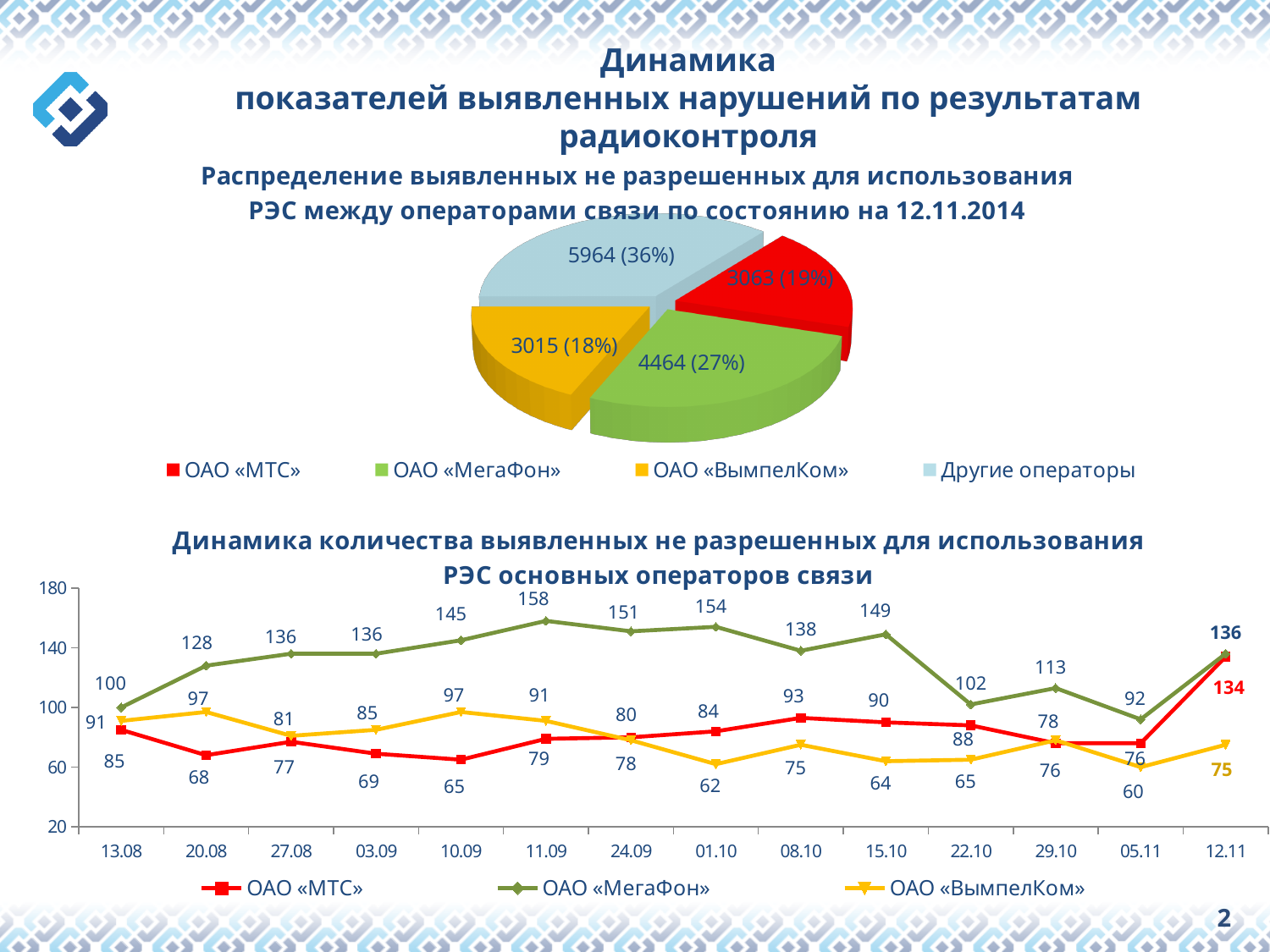
In the pie chart, what is the difference between the values for ОАО «МТС» and ОАО «ВымпелКом»? 48 In the pie chart, what value and share are shown for Другие операторы? 5964 (36%) In the line chart, what is the value for ОАО «МТС» on 12.11? 134 What type of chart is the bottom chart on the slide? Line chart How many series does the legend of the line chart list? 3 In the line chart, what is the value for ОАО «ВымпелКом» on 05.11? 60 In the pie chart, what value and share are shown for ОАО «МегаФон»? 4464 (27%) In the line chart, on which date does ОАО «МегаФон» reach its highest value? 11.09 How many dates are shown on the x axis of the line chart? 14 In the line chart, which is larger on 01.10: ОАО «МТС» or ОАО «ВымпелКом»? ОАО «МТС» In the line chart, what is the value for ОАО «МегаФон» on 11.09? 158 In the pie chart, which category has the smallest slice? ОАО «ВымпелКом»